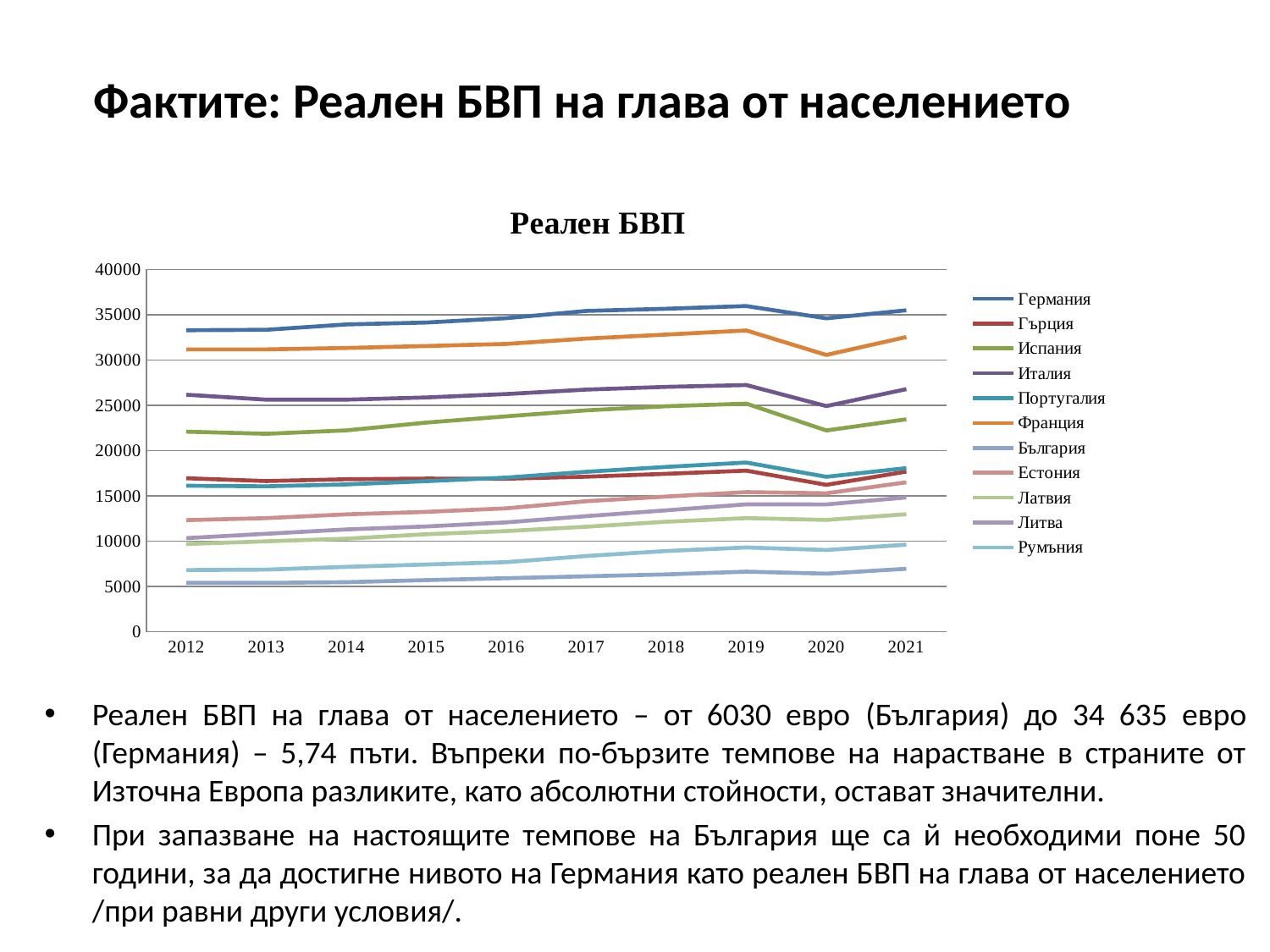
What is the title of the chart? Реален БВП In 2021, which is higher: the value for Франция or the value for Италия? Франция Is the value for България in 2021 greater or less than 10000? less Which country has the highest real GDP per capita line throughout the chart? Германия Is the value for Италия in 2019 greater or less than 25000? greater Is the value for Германия in 2012 greater or less than 30000? greater What kind of chart is shown on the slide? line chart Which country has the lowest real GDP per capita line throughout the chart? България How many series does the legend of the chart list? 11 Does the line for Германия rise or fall from 2012 to 2019? rise How many years are shown on the x axis of the chart? 10